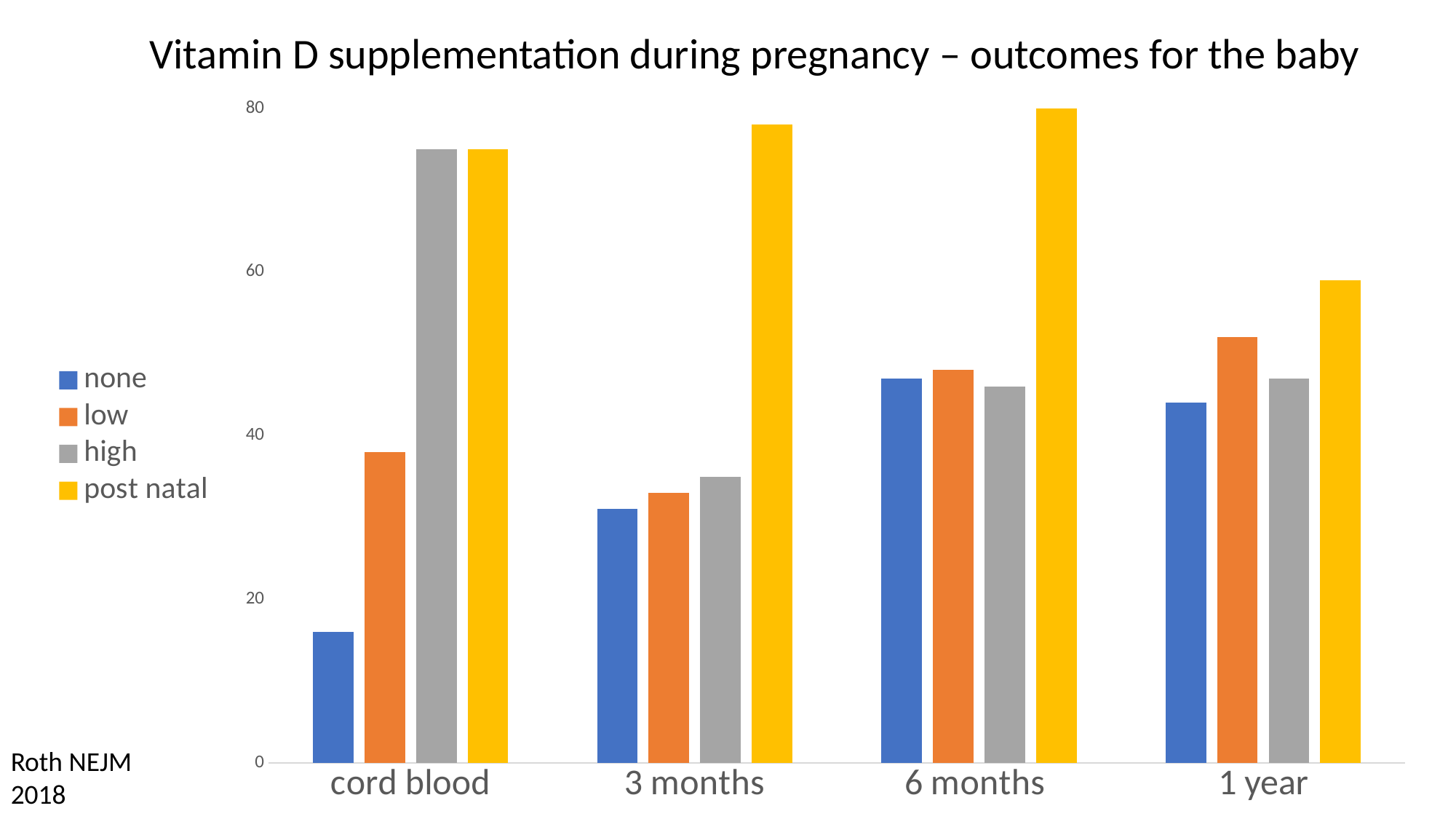
How many categories are shown on the x axis? 4 Is the value for post natal at 6 months greater or less than 60? greater Does the value for none rise or fall from cord blood to 6 months? rise Which series has the highest value at 3 months? post natal Is the value for high at 1 year greater or less than 40? greater How many series does the legend list? 4 At 1 year, which is larger: the value for low or the value for none? low What kind of chart is shown on the slide? bar chart What is the title of the chart? Vitamin D supplementation during pregnancy – outcomes for the baby Is the value for none at cord blood greater or less than 20? less Which series has the lowest value at cord blood? none